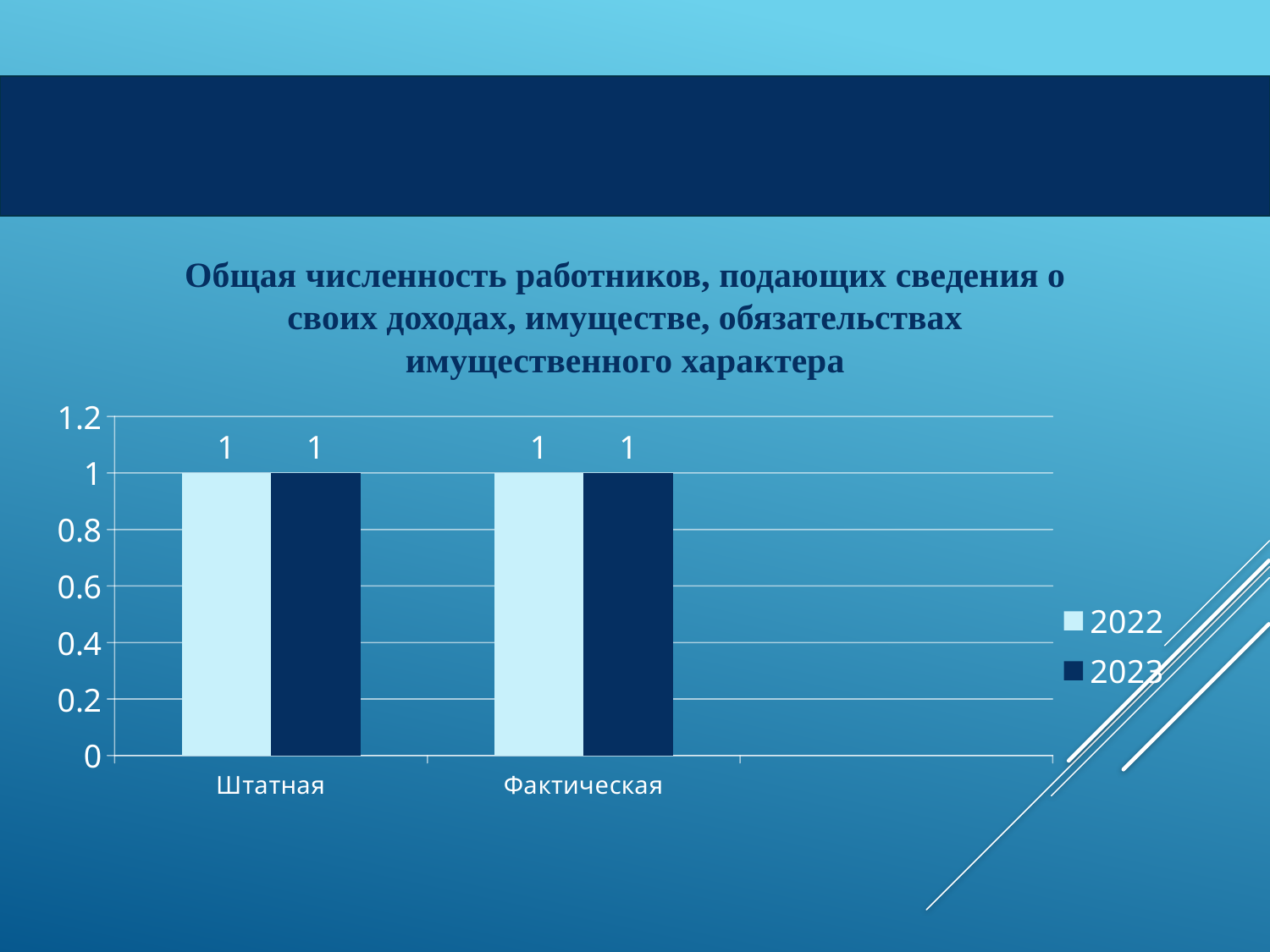
What is the value for Фактическая in the 2022 series? 1 What kind of chart is shown on the slide? bar chart Which series is shown in dark blue in the legend? 2023 What is the difference between the Штатная and Фактическая values in the 2023 series? 0 Is the 2023 value for Штатная greater or less than 1.2? less What is the difference between the 2022 and 2023 values for Штатная? 0 Is the 2022 value for Фактическая greater or less than 0.8? greater What is the value for Штатная in the 2023 series? 1 What is the value for Штатная in the 2022 series? 1 How many series does the legend list? 2 How many categories are shown on the x axis of the chart? 2 What is the value for Фактическая in the 2023 series? 1